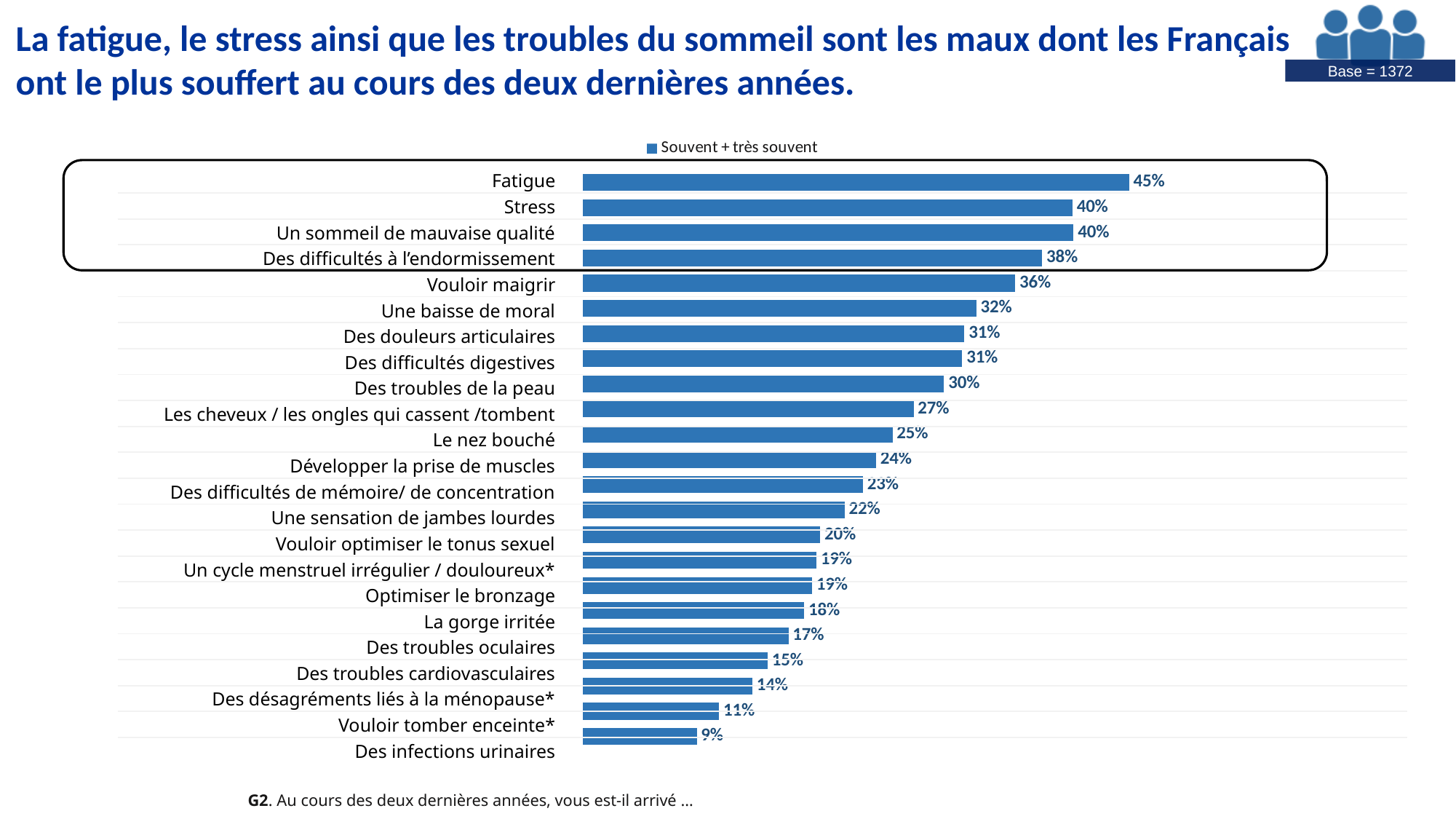
Which category has the lowest value? Des infections urinaires Which category has the highest value? Fatigue How many series does the legend list? 1 What kind of chart is shown on the slide? Bar chart What is the difference between the values for Fatigue and Stress? 5% How many categories are plotted in the chart? 23 What is the legend entry for the series shown in the chart? Souvent + très souvent What value is shown for Vouloir maigrir? 36% What percentage is shown for Fatigue? 45% What is the difference between the values for Le nez bouché and Des troubles cardiovasculaires? 10% Which is larger: the value for Une baisse de moral or the value for Des troubles de la peau? Une baisse de moral What percentage is shown for Des infections urinaires? 9%